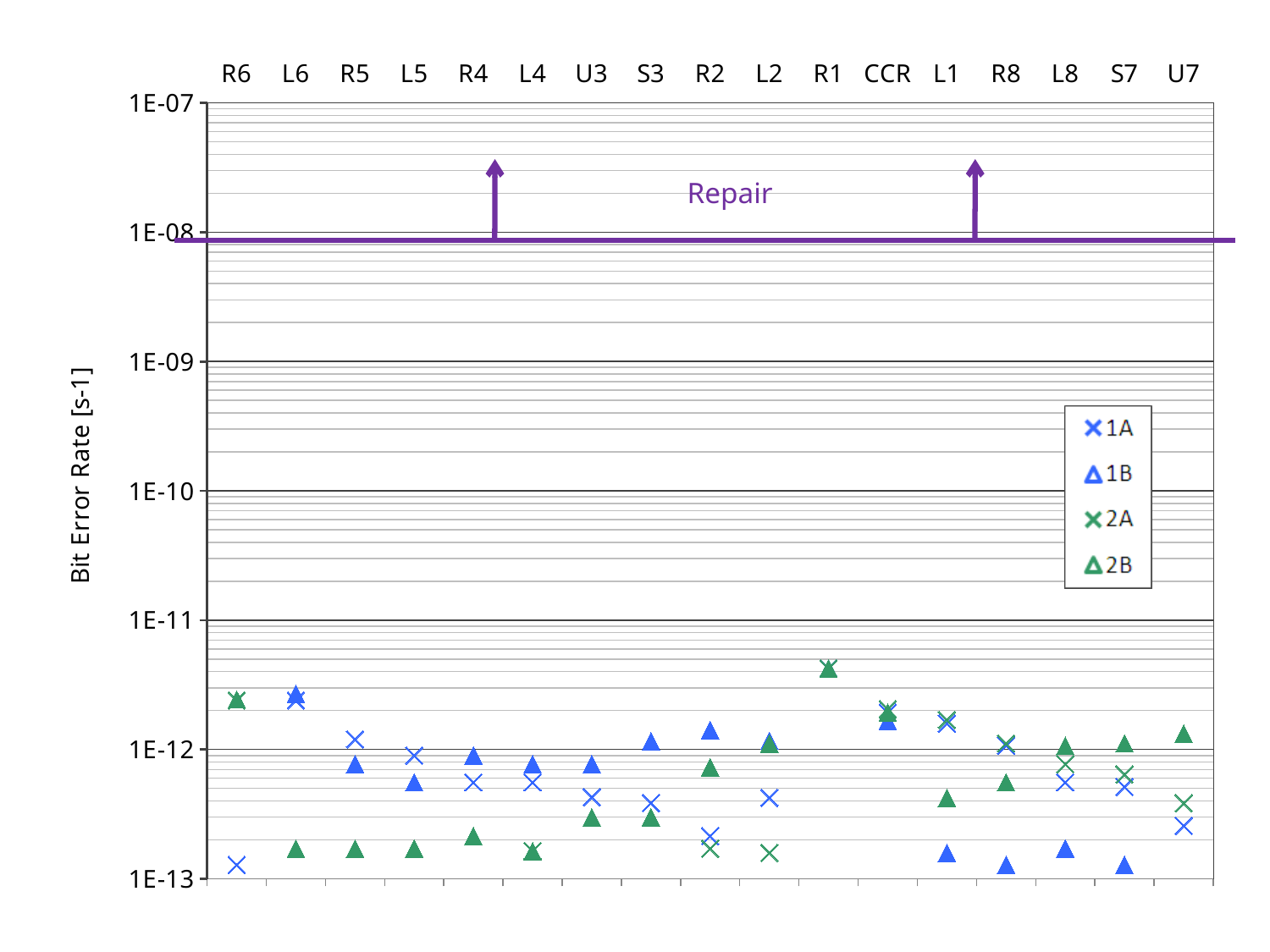
What kind of chart is shown on the slide? scatter chart Is the value for series 1B at S7 greater or less than 1E-12? less How many series does the legend list? 4 Is the value for series 2B at L6 greater or less than 1E-12? less What is the y-axis title of the chart? Bit Error Rate [s-1] Is the value for series 1A at R6 greater or less than 1E-12? less What word is written in the purple annotation above the chart's data? Repair For series 2A, which category has the highest value? R1 How many categories are shown along the x axis? 17 For series 2A, which is larger: the value at R1 or the value at L2? R1